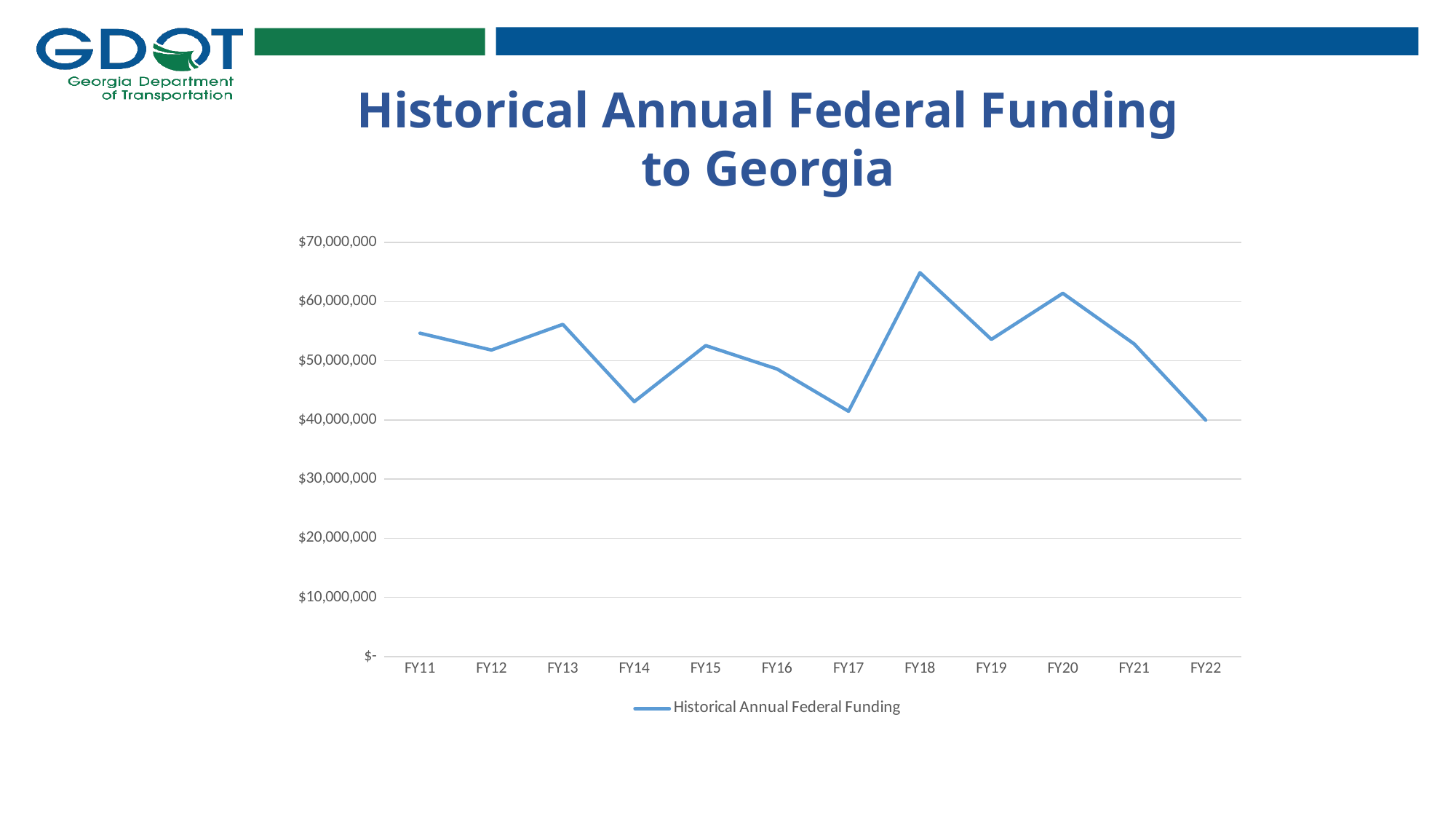
Is the value for FY17 greater or less than $50,000,000? less Which fiscal year has the lowest federal funding? FY22 Is the value for FY14 greater or less than $50,000,000? less What is the name of the series shown in the legend? Historical Annual Federal Funding Which is larger, the value for FY20 or the value for FY14? FY20 How many series does the legend list? 1 Which fiscal year has the highest federal funding? FY18 Is the value for FY13 greater or less than $50,000,000? greater What kind of chart is shown on the slide? Line chart How many fiscal years are plotted on the x axis? 12 Do the values rise or fall from FY20 to FY22? fall